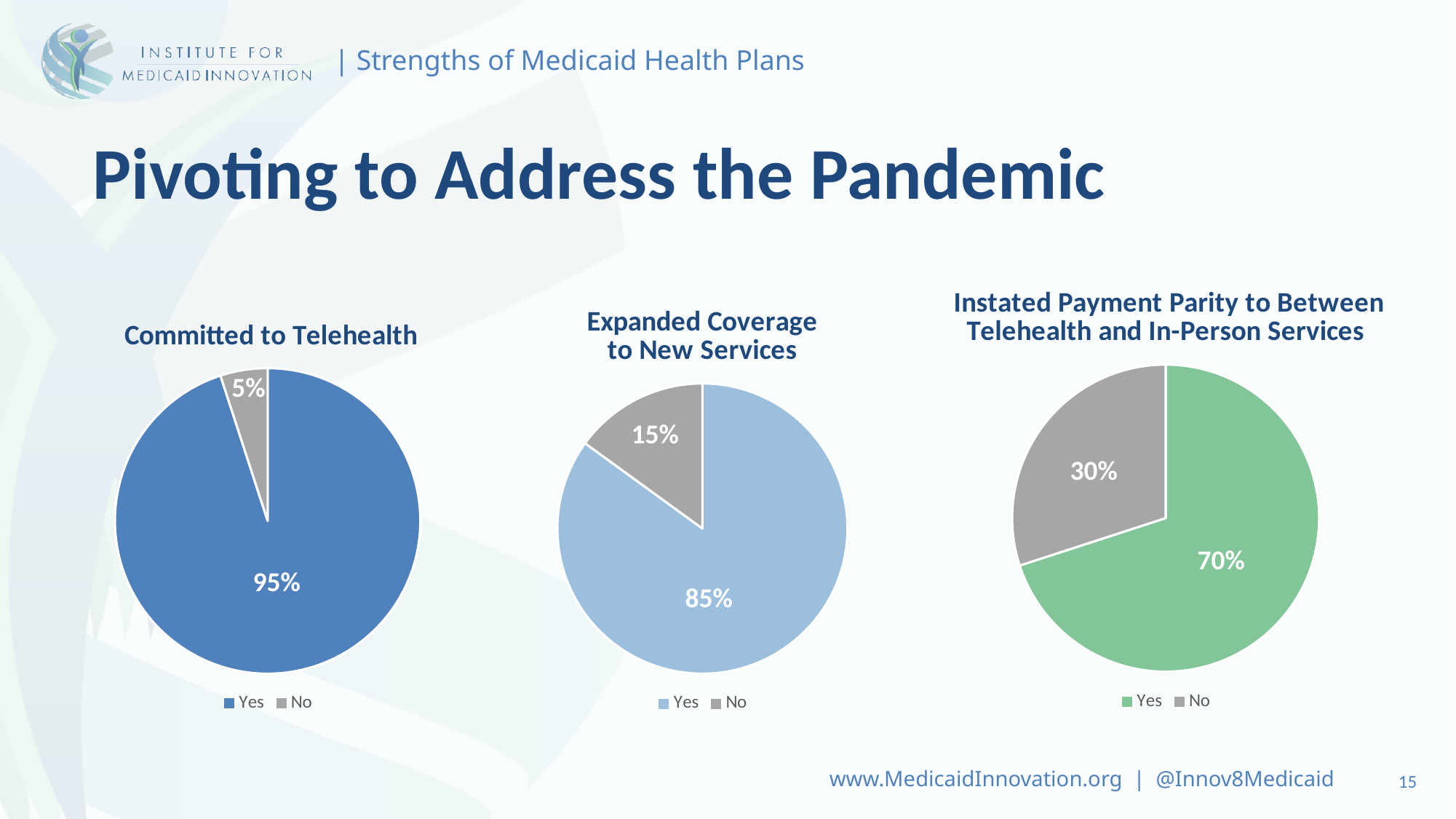
In the 'Committed to Telehealth' chart, what is the value for 'No'? 5% In the 'Instated Payment Parity to Between Telehealth and In-Person Services' chart, what is the value for 'No'? 30% In the 'Expanded Coverage to New Services' chart, what share of the pie is 'No'? 15% In the 'Instated Payment Parity to Between Telehealth and In-Person Services' chart, what is the value for 'Yes'? 70% What kind of chart is the 'Expanded Coverage to New Services' chart? Pie chart In the 'Committed to Telehealth' chart, which category is the smallest? No In the 'Instated Payment Parity to Between Telehealth and In-Person Services' chart, what is the difference between the 'Yes' and 'No' values? 40% What colour is the 'Yes' slice in the 'Instated Payment Parity to Between Telehealth and In-Person Services' chart? Green In the 'Committed to Telehealth' chart, what share of the pie is 'Yes'? 95% In the 'Expanded Coverage to New Services' chart, what is the value for 'Yes'? 85% How many slices does the 'Instated Payment Parity to Between Telehealth and In-Person Services' chart have? 2 In the 'Expanded Coverage to New Services' chart, which slice is larger, 'Yes' or 'No'? Yes